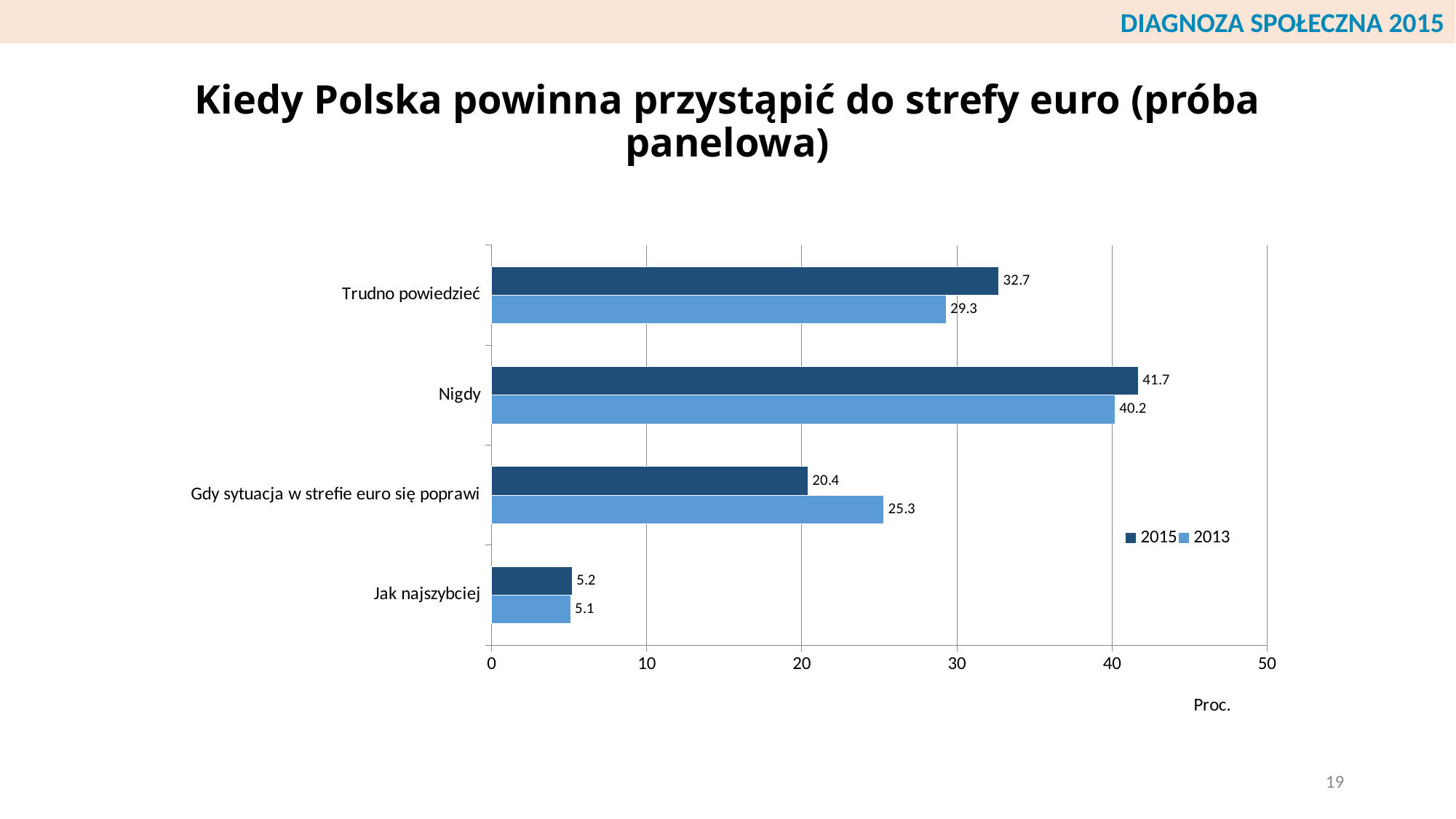
Is the 2015 value for "Gdy sytuacja w strefie euro się poprawi" greater or less than 30? less How many categories are shown on the chart? 4 What is the 2013 value for "Gdy sytuacja w strefie euro się poprawi"? 25.3 Which category has the lowest 2013 value? Jak najszybciej What is the difference between the 2015 and 2013 values for "Trudno powiedzieć"? 3.4 For "Nigdy", which year has the larger value, 2015 or 2013? 2015 What is the difference between the 2013 and 2015 values for "Gdy sytuacja w strefie euro się poprawi"? 4.9 What kind of chart is shown on the slide? Bar chart What is the 2015 value for "Nigdy"? 41.7 What is the 2013 value for "Trudno powiedzieć"? 29.3 How many series does the legend list? 2 Which category has the highest 2015 value? Nigdy